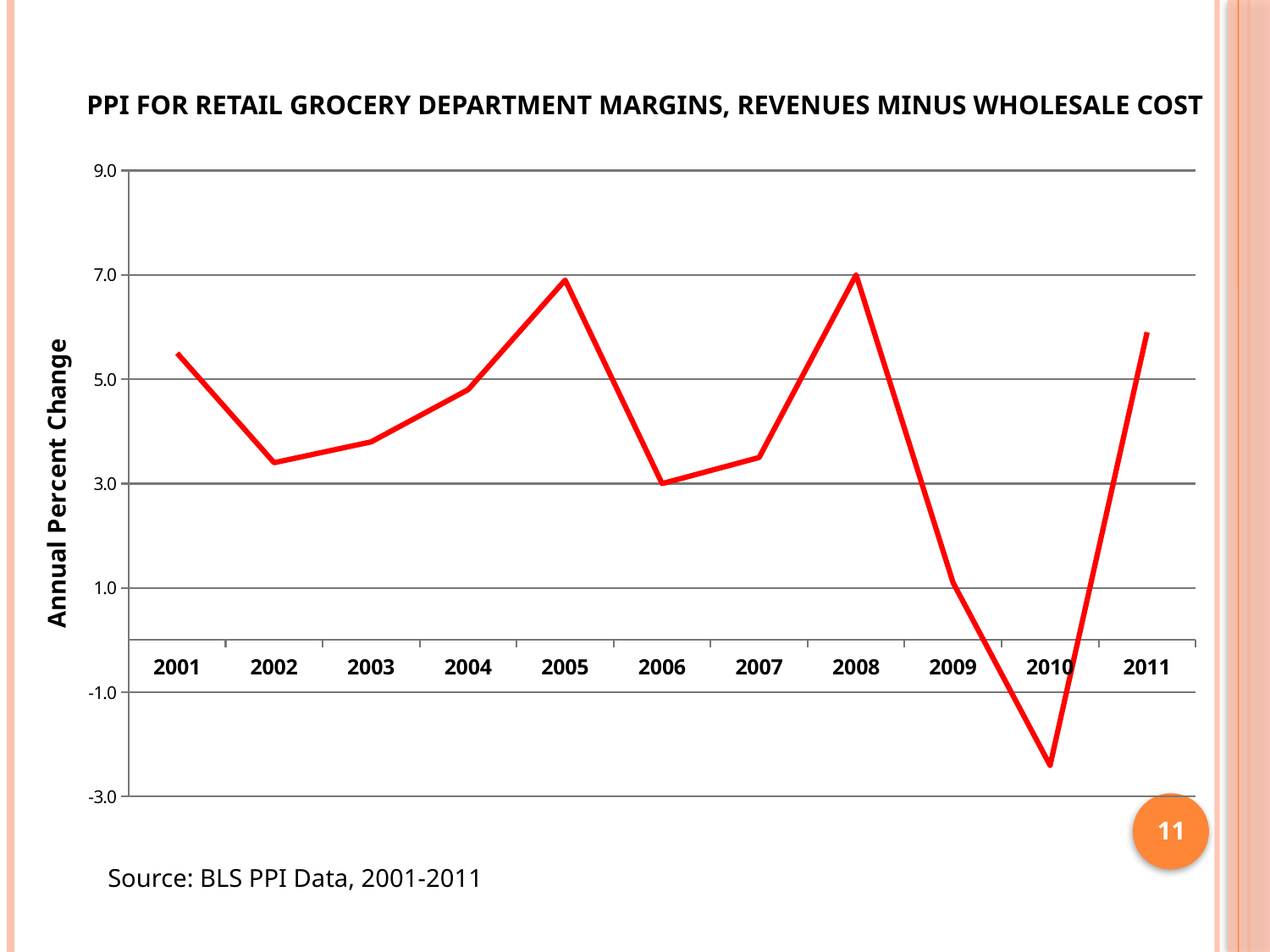
Which year has the larger value, 2008 or 2009? 2008 Is the value for 2010 greater or less than -1.0? less How many years are plotted on the x axis? 11 What kind of chart is shown on the slide? Line chart Which year has the larger value, 2010 or 2011? 2011 Is the value for 2009 greater or less than 3.0? less Is the value for 2003 greater or less than 5.0? less Does the line rise or fall from 2008 to 2010? Falls Which year has the lowest annual percent change? 2010 What is the label on the vertical axis? Annual Percent Change